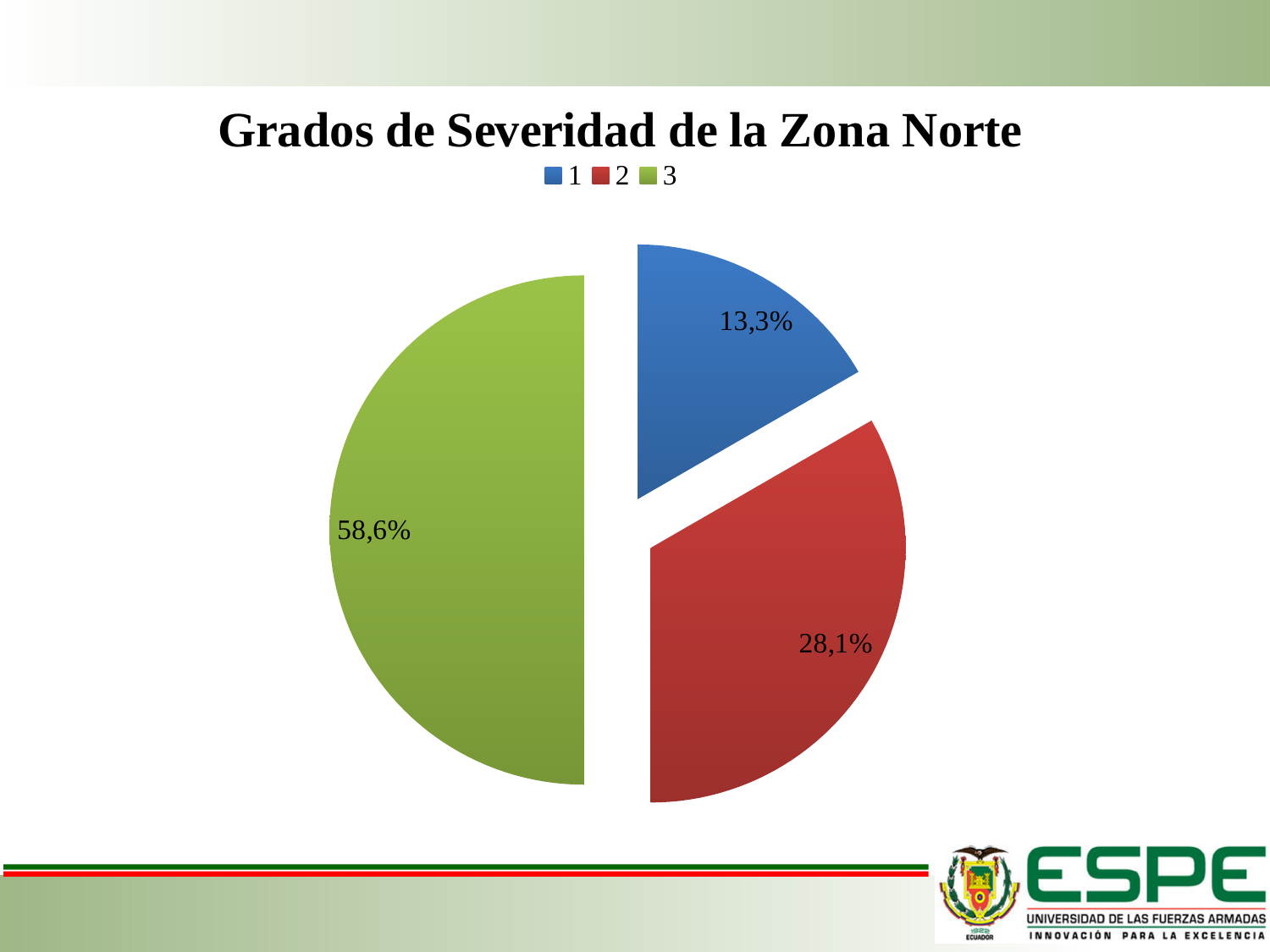
What is the title of the chart? Grados de Severidad de la Zona Norte What percentage does category 1 represent? 13,3% Which category has the largest share of the pie? 3 What kind of chart is shown on the slide? pie chart How many entries does the legend list? 3 What percentage does category 2 represent? 28,1% How many slices does the pie chart have? 3 What is the difference in percentage points between category 3 and category 2? 30,5 Which is larger, the share for category 2 or category 1? 2 What colour is the slice for category 3? green Which category has the smallest share of the pie? 1 What percentage does category 3 represent? 58,6%